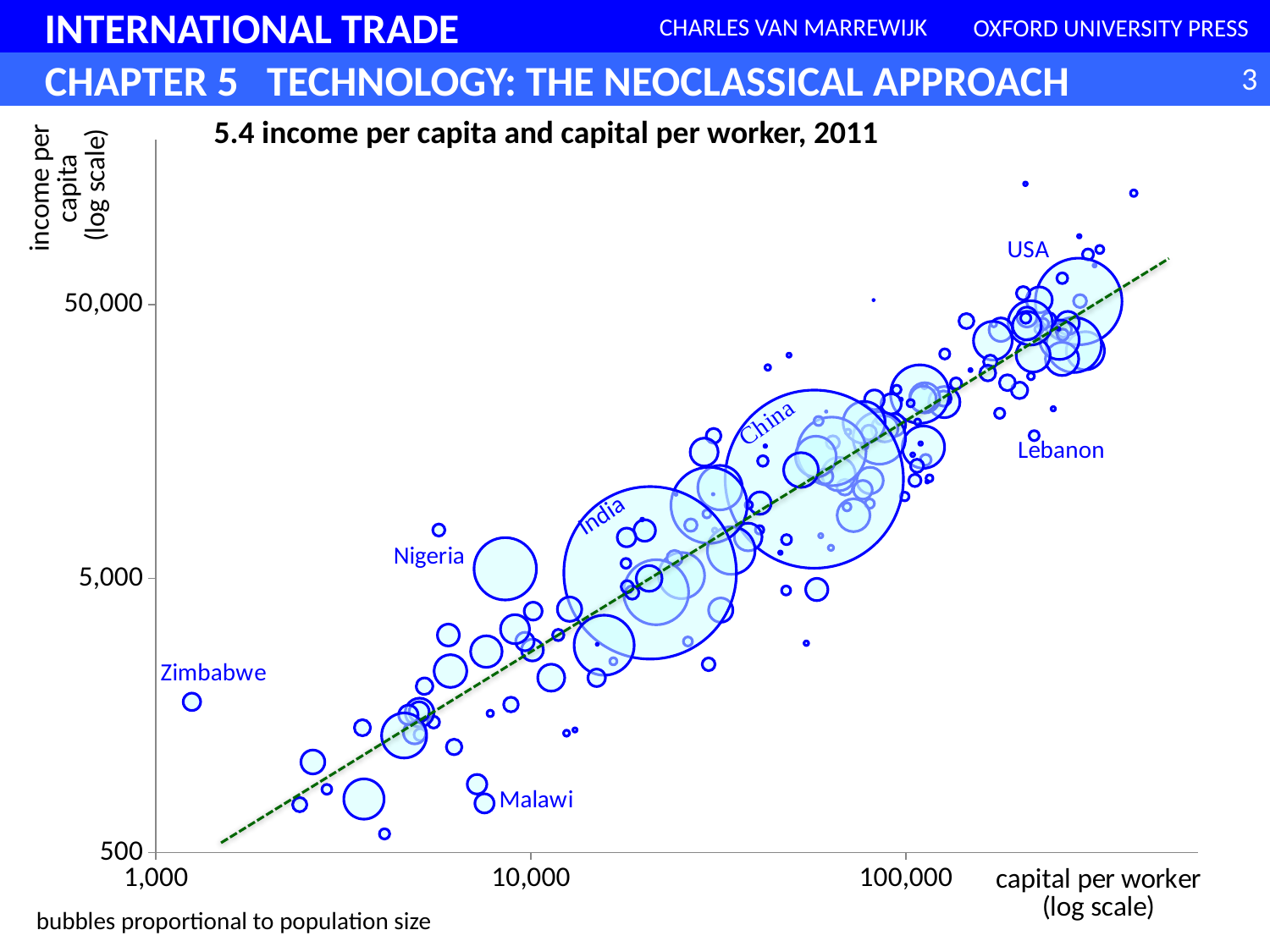
Is the income per capita for China greater or less than 5,000? greater Is the capital per worker for the USA greater or less than 100,000? greater Is the capital per worker for China greater or less than 10,000? greater What do the bubble sizes in the chart represent? population size Which country has the higher income per capita, the USA or Zimbabwe? USA What kind of chart is shown on the slide? bubble chart Which country has the larger capital per worker, China or Malawi? China What is the title of the chart? 5.4 income per capita and capital per worker, 2011 Does income per capita generally rise or fall as capital per worker increases along the x axis? rise